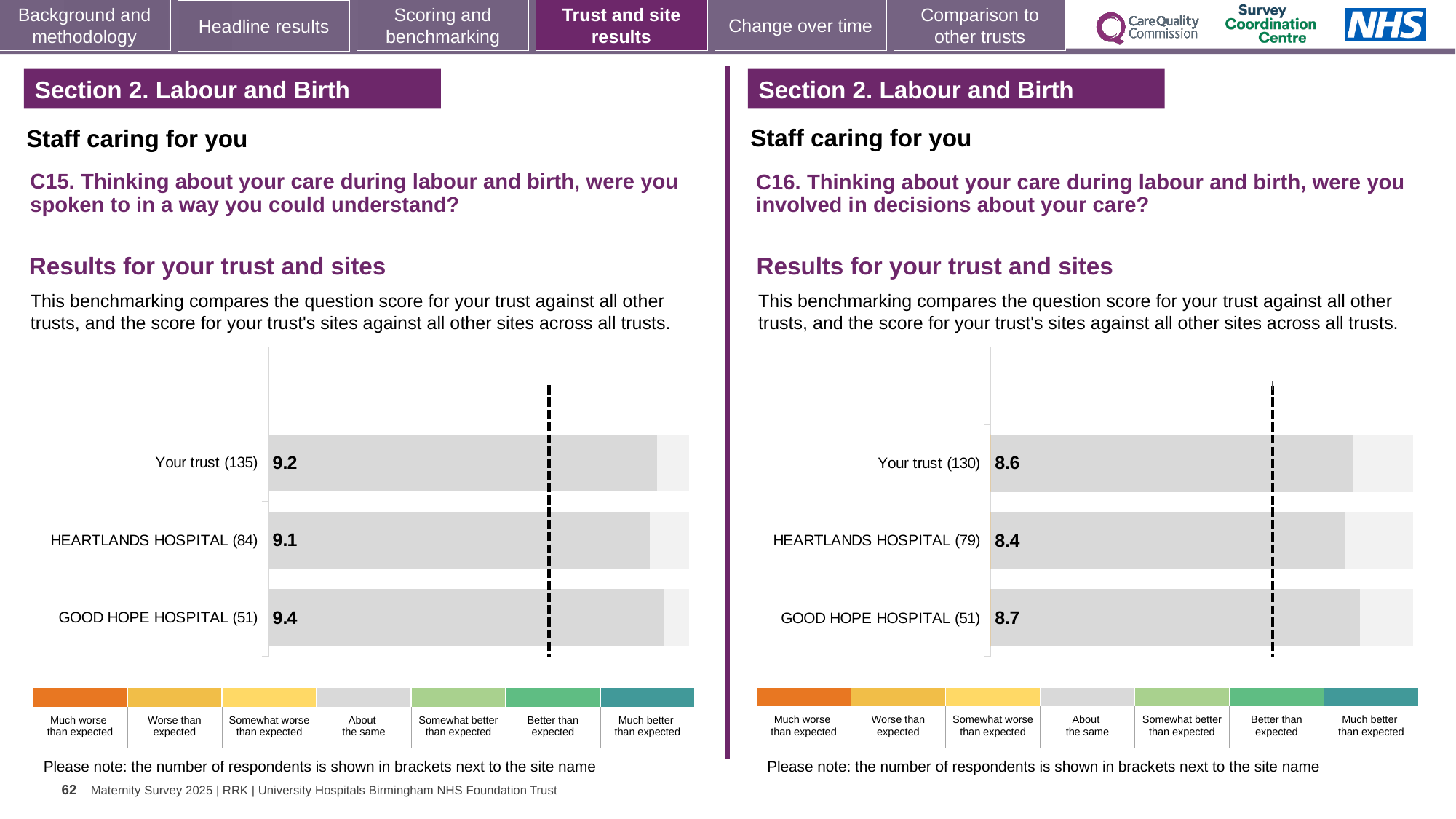
In the C16 chart on the right, which is larger, the score for Your trust or the score for HEARTLANDS HOSPITAL? Your trust In the C15 chart on the left, which site or trust has the lowest score? HEARTLANDS HOSPITAL What type of chart is used in the C15 chart on the left? Bar chart In the C15 chart on the left, what is the score for GOOD HOPE HOSPITAL? 9.4 In the C16 chart on the right, what is the difference between the scores for GOOD HOPE HOSPITAL and Your trust? 0.1 In the C15 chart on the left, what is the score for Your trust? 9.2 In the C15 chart on the left, what is the difference between the scores for GOOD HOPE HOSPITAL and HEARTLANDS HOSPITAL? 0.3 In the C16 chart on the right, which site or trust has the highest score? GOOD HOPE HOSPITAL In the C16 chart on the right, how many respondents are shown in brackets for Your trust? 130 In the C15 chart on the left, how many bars are plotted? 3 In the C16 chart on the right, what is the score for HEARTLANDS HOSPITAL? 8.4 In the C16 chart on the right, what is the score for Your trust? 8.6